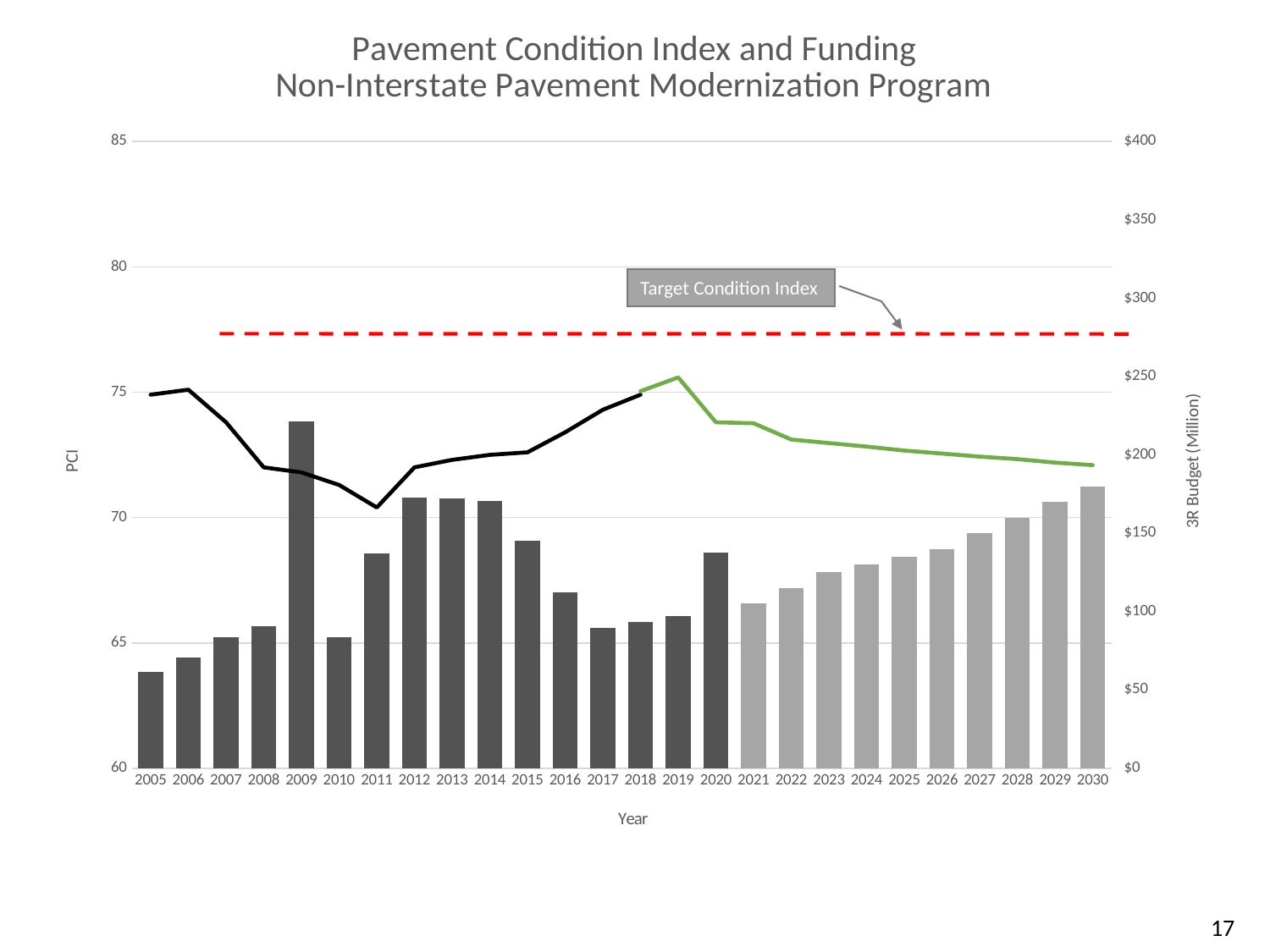
What kind of chart is shown on the slide? A combined bar and line chart Is the 3R Budget bar for 2005 greater or less than $100 million? less Is the PCI value for 2011 greater or less than 75? less Do the 3R Budget bars rise or fall from 2021 to 2030? Rise Does the green PCI line rise or fall from 2019 to 2030? Fall Which year has the tallest 3R Budget bar? 2009 Is the 3R Budget bar for 2030 greater or less than $150 million? greater Which year has the shortest 3R Budget bar? 2005 How many years are shown along the x axis of the chart? 26 Which year has a larger 3R Budget bar, 2021 or 2030? 2030 What does the dashed red horizontal line represent? Target Condition Index